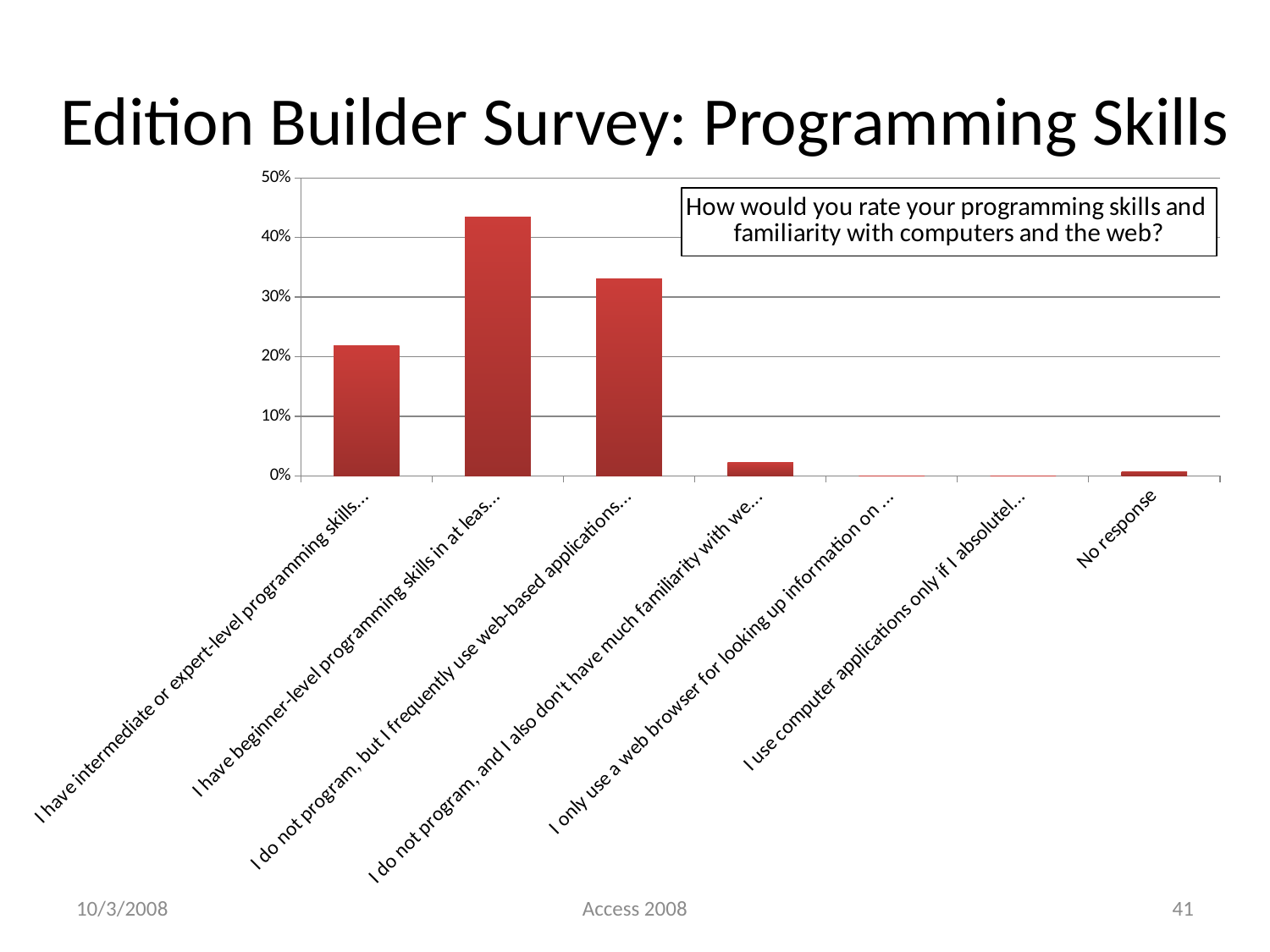
Which is larger: the value for "I have beginner-level programming skills in at leas..." or the value for "No response"? I have beginner-level programming skills in at leas... How many categories are plotted on the x axis of the chart? 7 Which category has the highest bar in the chart? I have beginner-level programming skills in at leas... Is the value for "I have beginner-level programming skills in at leas..." greater or less than 40%? greater Is the value for "No response" greater or less than 10%? less Is the value for "I do not program, but I frequently use web-based applications..." greater or less than 30%? greater What survey question is shown in the text box on the chart? How would you rate your programming skills and familiarity with computers and the web? What is the highest value shown on the y axis of the chart? 50% Which is larger: the value for "I have intermediate or expert-level programming skills..." or the value for "I do not program, but I frequently use web-based applications..."? I do not program, but I frequently use web-based applications... What kind of chart is shown on the slide? bar chart